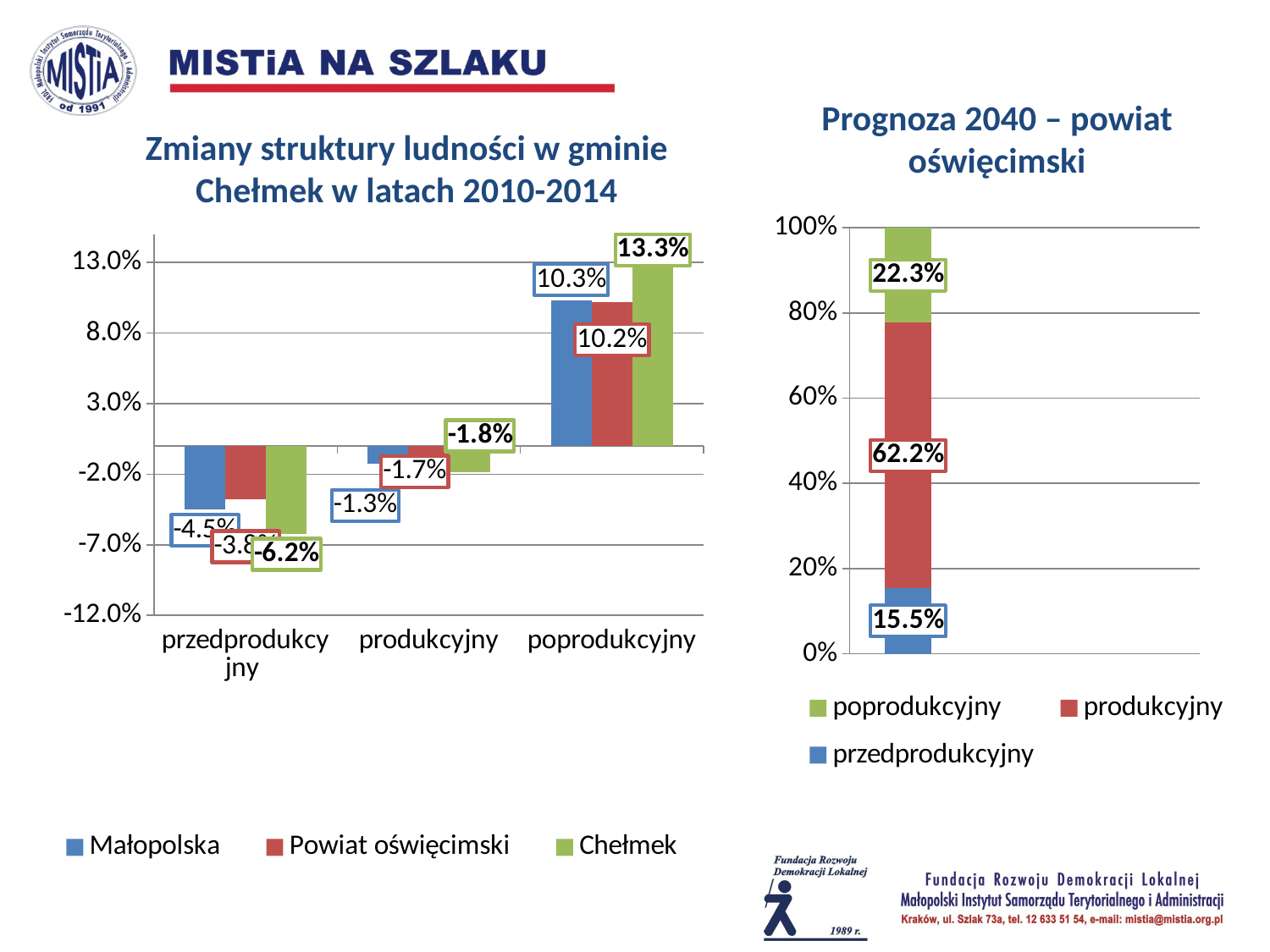
In the chart 'Prognoza 2040 – powiat oświęcimski', which segment is the smallest? przedprodukcyjny In the chart 'Prognoza 2040 – powiat oświęcimski', what is the share of the produkcyjny segment? 62.2% In the chart 'Zmiany struktury ludności w gminie Chełmek w latach 2010-2014', what is the value for Powiat oświęcimski in the produkcyjny category? -1.7% In the chart 'Prognoza 2040 – powiat oświęcimski', what is the difference between the poprodukcyjny and przedprodukcyjny segments? 6.8% In the chart 'Zmiany struktury ludności w gminie Chełmek w latach 2010-2014', which series has the lowest value in the przedprodukcyjny category? Chełmek In the chart 'Zmiany struktury ludności w gminie Chełmek w latach 2010-2014', what is the difference between the Chełmek and Małopolska values in the poprodukcyjny category? 3.0% In the chart 'Zmiany struktury ludności w gminie Chełmek w latach 2010-2014', which series has the highest value in the poprodukcyjny category? Chełmek In the chart 'Zmiany struktury ludności w gminie Chełmek w latach 2010-2014', which is larger in the produkcyjny category: Małopolska or Chełmek? Małopolska What kind of chart is 'Zmiany struktury ludności w gminie Chełmek w latach 2010-2014'? Bar chart How many series does the legend of the chart 'Zmiany struktury ludności w gminie Chełmek w latach 2010-2014' list? 3 In the chart 'Zmiany struktury ludności w gminie Chełmek w latach 2010-2014', what is the value for Chełmek in the poprodukcyjny category? 13.3% In the chart 'Zmiany struktury ludności w gminie Chełmek w latach 2010-2014', what is the value for Małopolska in the przedprodukcyjny category? -4.5%